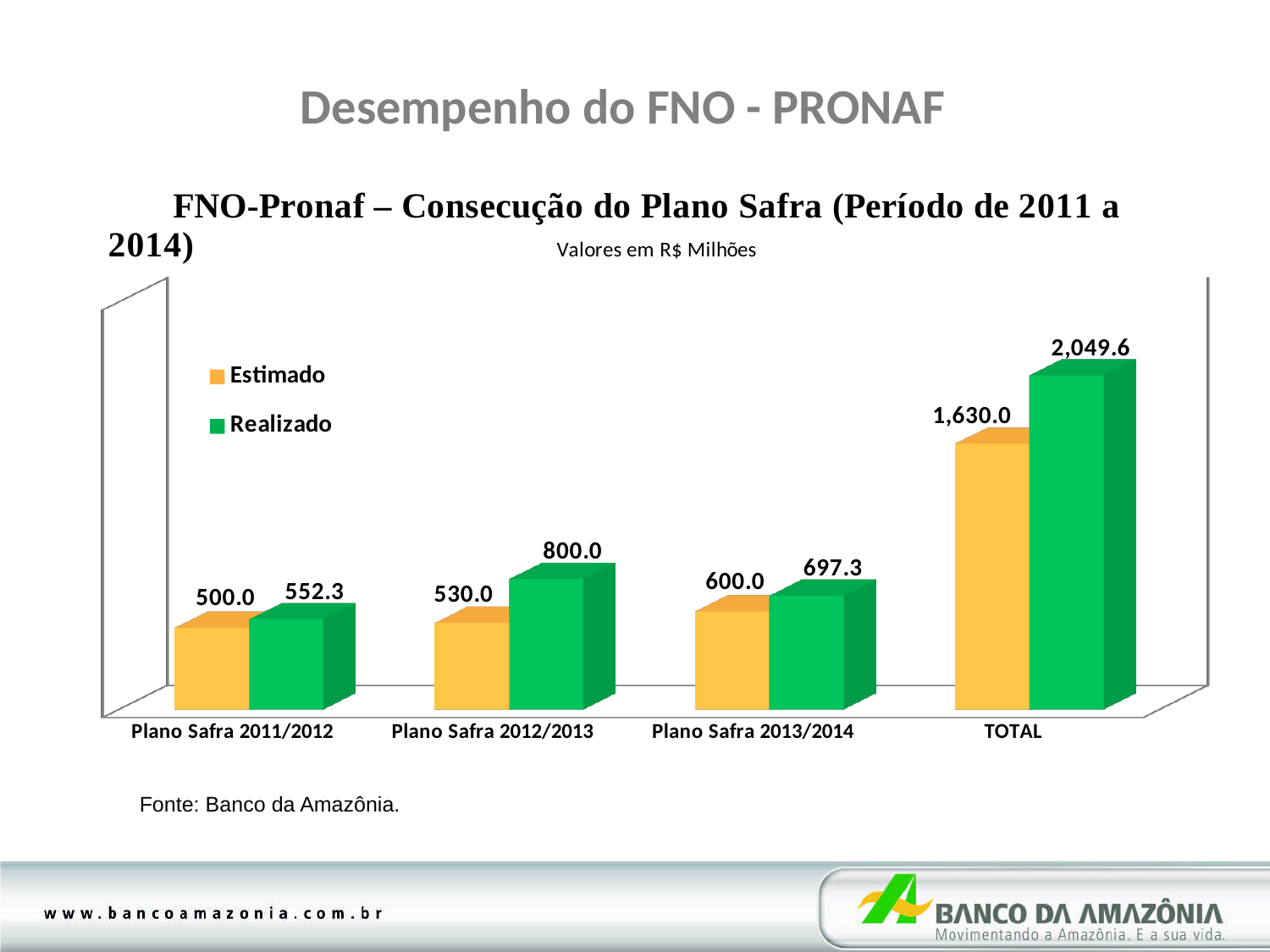
Excluding TOTAL, which Plano Safra has the highest Realizado value? Plano Safra 2012/2013 What is the difference between the Realizado and Estimado values for TOTAL? 419.6 What kind of chart is shown on the slide? Bar chart What is the difference between the Realizado and Estimado values for Plano Safra 2013/2014? 97.3 What is the Estimado value for Plano Safra 2013/2014? 600.0 What is the Estimado value for Plano Safra 2011/2012? 500.0 What is the Realizado value for TOTAL? 2,049.6 How many series does the legend list? 2 Excluding TOTAL, which Plano Safra has the lowest Estimado value? Plano Safra 2011/2012 How many categories are shown on the x axis? 4 Which is larger for Plano Safra 2011/2012, Estimado or Realizado? Realizado What is the Realizado value for Plano Safra 2012/2013? 800.0